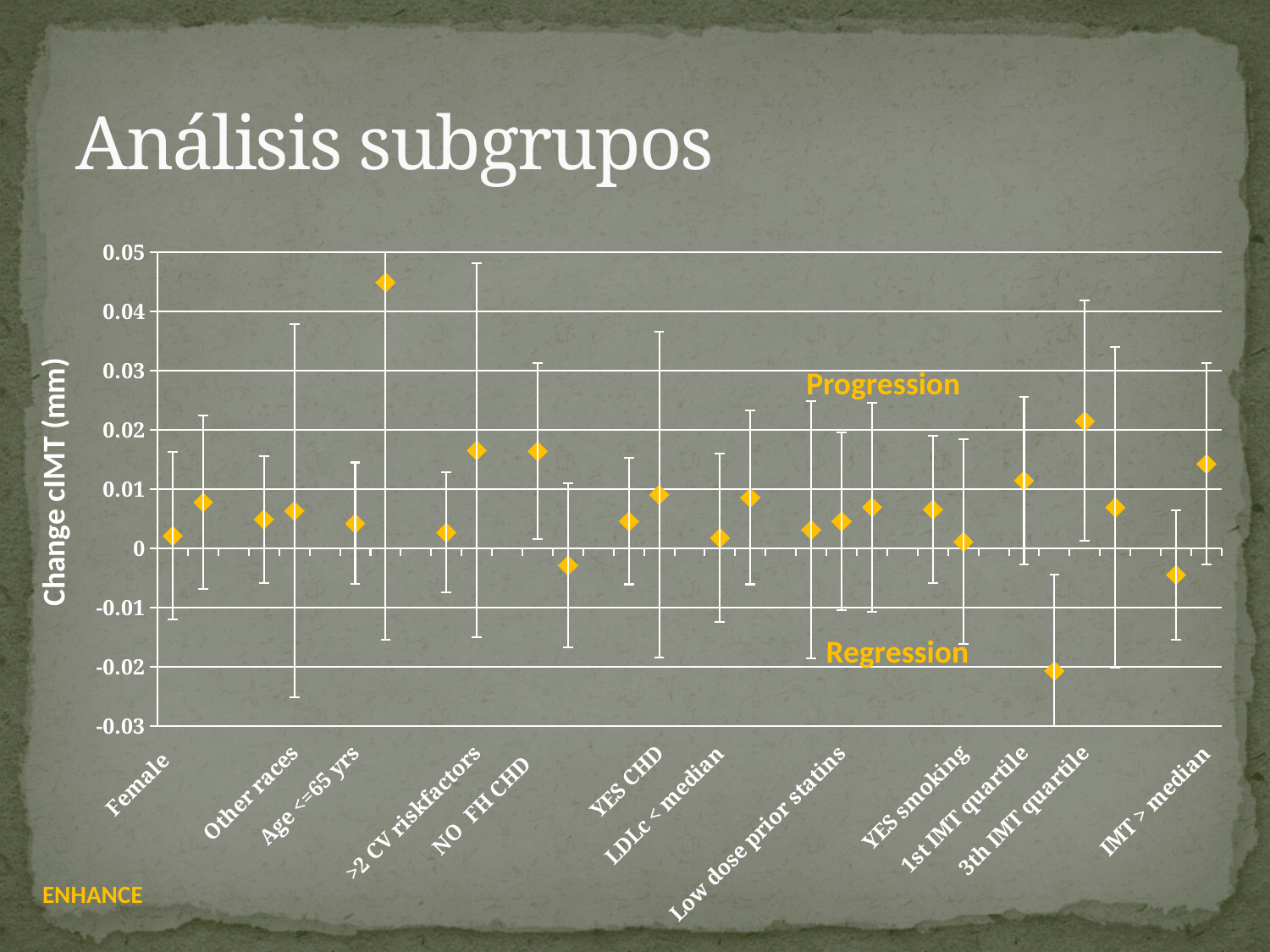
What is the lowest tick value shown on the vertical axis? -0.03 Is the value for Female greater or less than 0.01? less What is the highest tick value shown on the vertical axis? 0.05 What kind of chart is shown on the slide? scatter chart What is the label of the vertical axis? Change cIMT (mm) Is the highest plotted value on the chart greater or less than 0.04? greater Which word is written on the chart above the zero line, and which below it? Progression above, Regression below Is the lowest plotted value on the chart greater or less than -0.01? less Are most of the plotted points above or below the zero line? above